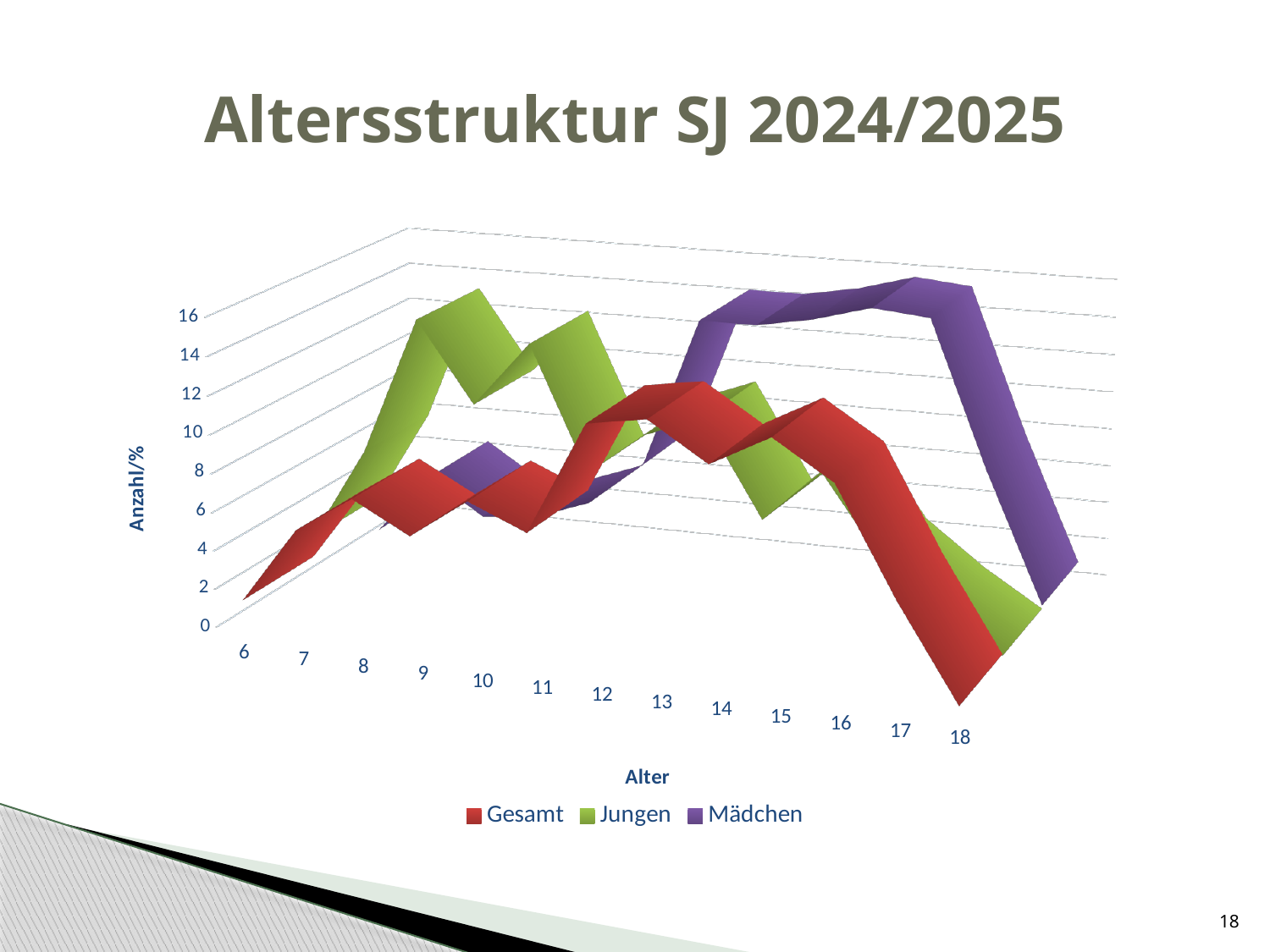
How many age categories are shown on the x axis? 13 Which series are listed in the legend? Gesamt, Jungen, Mädchen How many series does the legend list? 3 Is the value for Gesamt at age 6 greater or less than 4? less What kind of chart is this? 3D line chart Does the Gesamt series rise or fall from age 6 to age 7? rise At age 9, which series has the larger value, Jungen or Gesamt? Jungen Does the Gesamt series rise or fall from age 16 to age 18? fall What is the title of the chart? Altersstruktur SJ 2024/2025 At age 16, which series has the larger value, Mädchen or Jungen? Mädchen Does the Mädchen series rise or fall from age 17 to age 18? fall